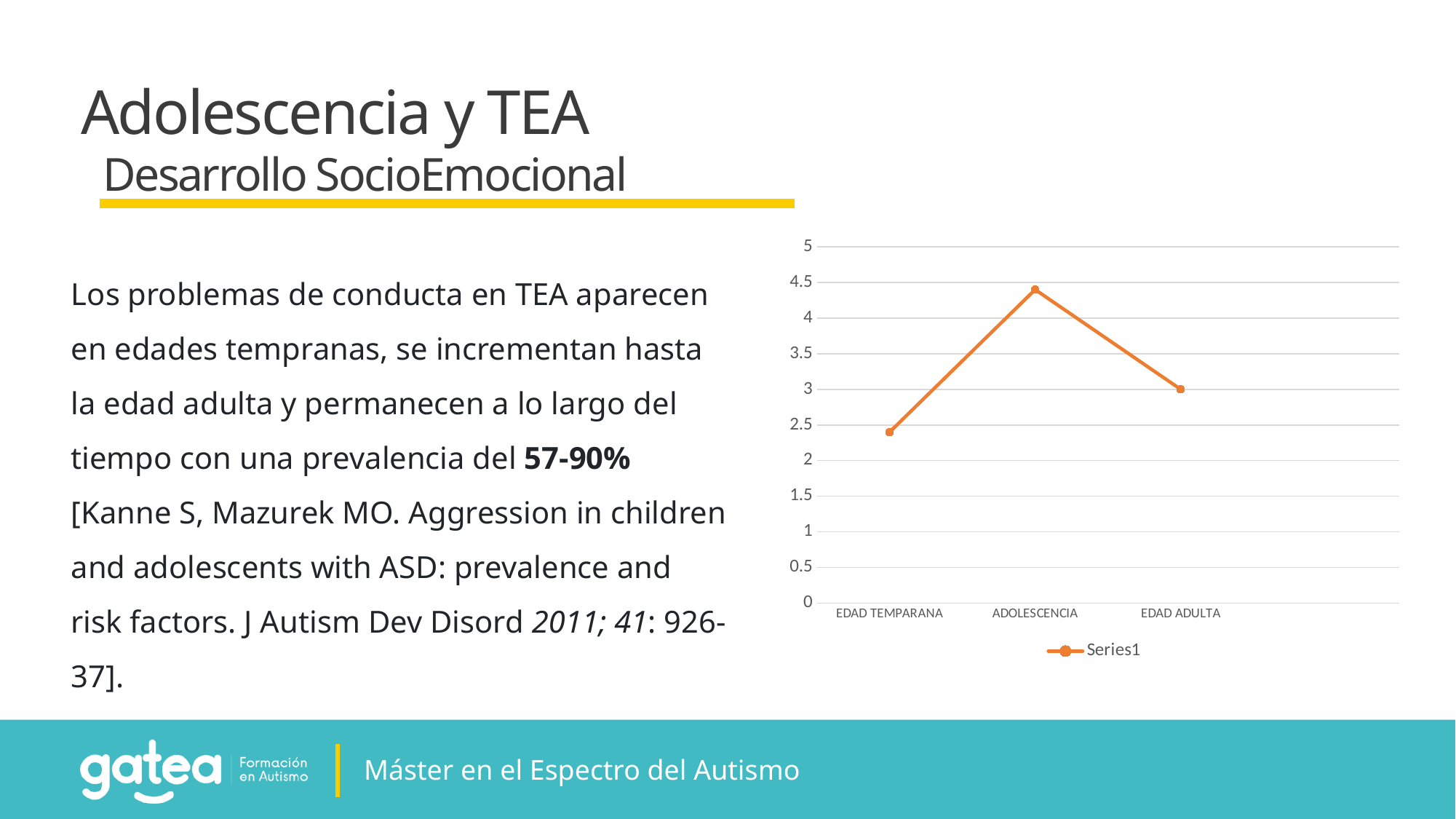
Is the value for EDAD ADULTA greater or less than 4? less Which is larger, the value for ADOLESCENCIA or the value for EDAD ADULTA? ADOLESCENCIA Which is larger, the value for EDAD ADULTA or the value for EDAD TEMPARANA? EDAD ADULTA How many series does the chart legend list? 1 What kind of chart is shown on the slide? line chart Is the value for ADOLESCENCIA greater or less than 4? greater What is the name of the series shown in the chart legend? Series1 Does the line rise or fall between EDAD TEMPARANA and ADOLESCENCIA? rise Which category has the lowest value in the chart? EDAD TEMPARANA Is the value for EDAD TEMPARANA greater or less than 3? less How many categories are shown on the x axis of the chart? 3 Which category has the highest value in the chart? ADOLESCENCIA